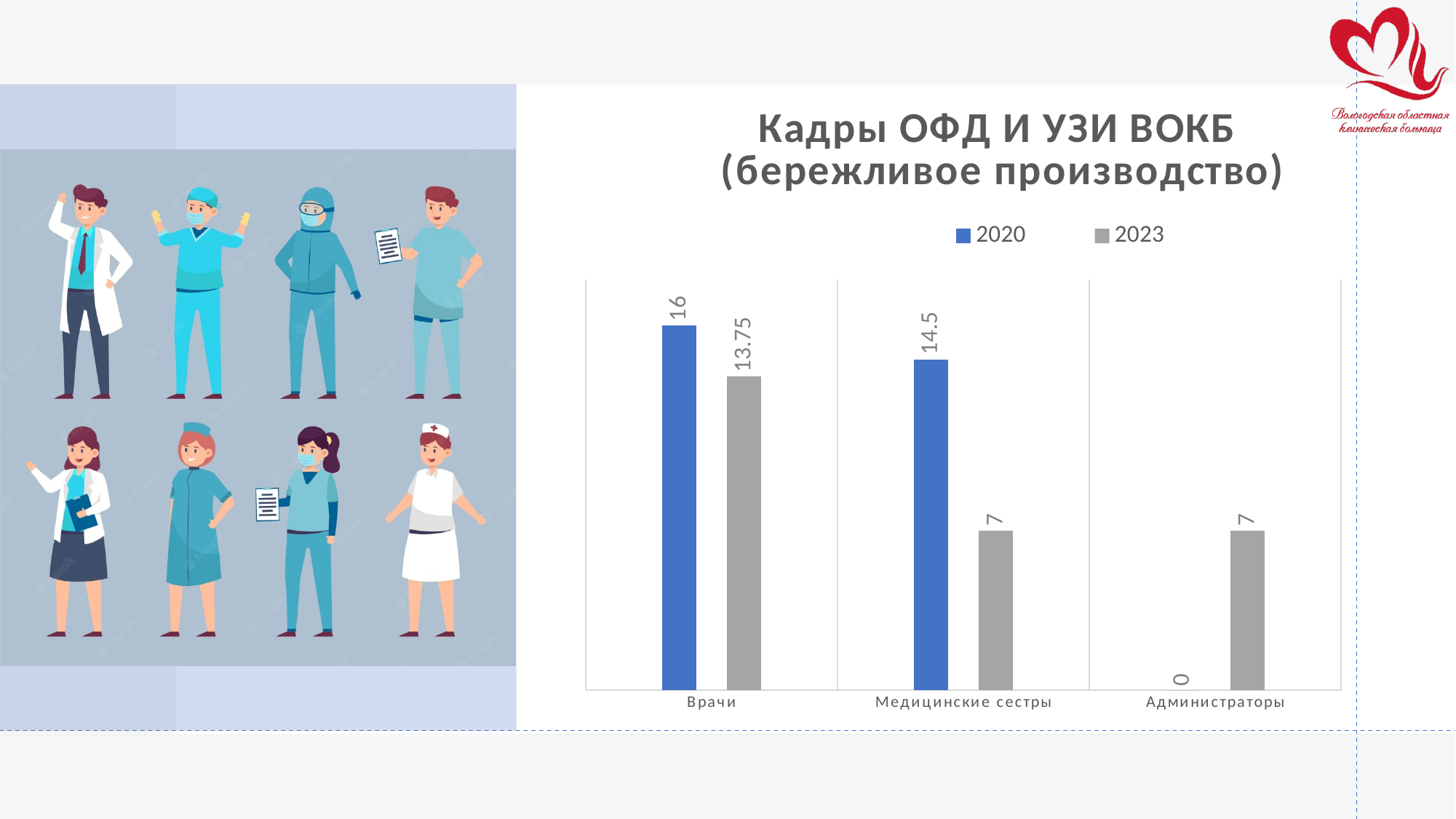
What is the 2023 value for Администраторы? 7 What is the 2020 value for Врачи? 16 What is the 2020 value for Администраторы? 0 How many series does the legend list? 2 Which is larger for Врачи: the 2020 value or the 2023 value? 2020 What kind of chart is shown on the slide? Bar chart Which category has the lowest 2020 value? Администраторы Which category has the highest 2020 value? Врачи How many categories are shown on the x axis? 3 What is the difference between the 2020 and 2023 values for Медицинские сестры? 7.5 What is the 2020 value for Медицинские сестры? 14.5 What is the 2023 value for Врачи? 13.75